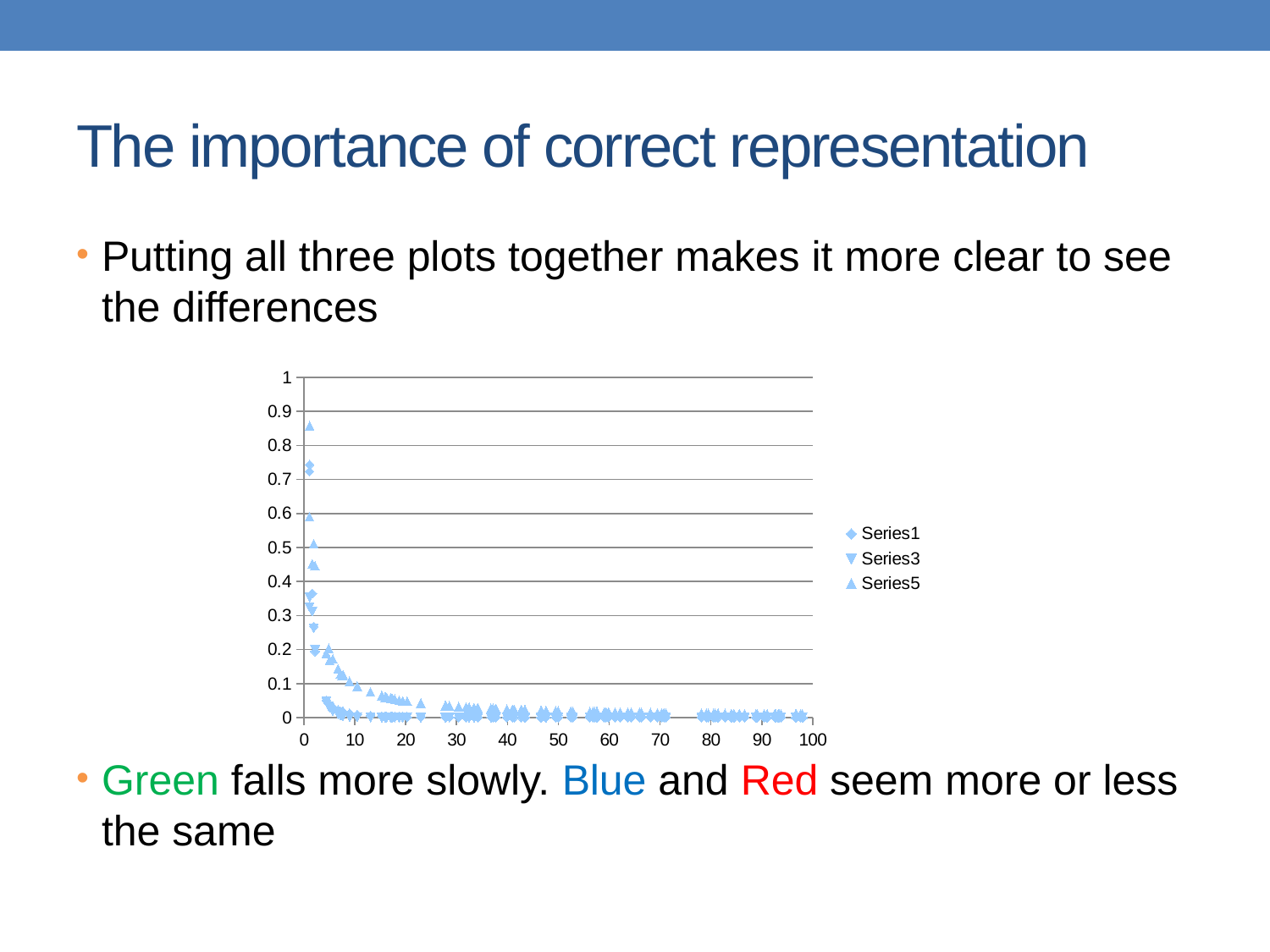
Is the highest value for Series5 greater or less than 0.8? greater What kind of chart is shown on the slide? Scatter chart What are the names of the series listed in the chart's legend? Series1, Series3, Series5 Which series reaches the highest value on the chart? Series5 How many series does the chart's legend list? 3 Is the highest value for Series3 greater or less than 0.5? less Which series has the larger maximum value, Series5 or Series3? Series5 What is the highest tick value shown on the chart's y axis? 1 Is the highest value for Series1 greater or less than 0.5? greater Do the plotted values rise or fall as the x axis increases? fall